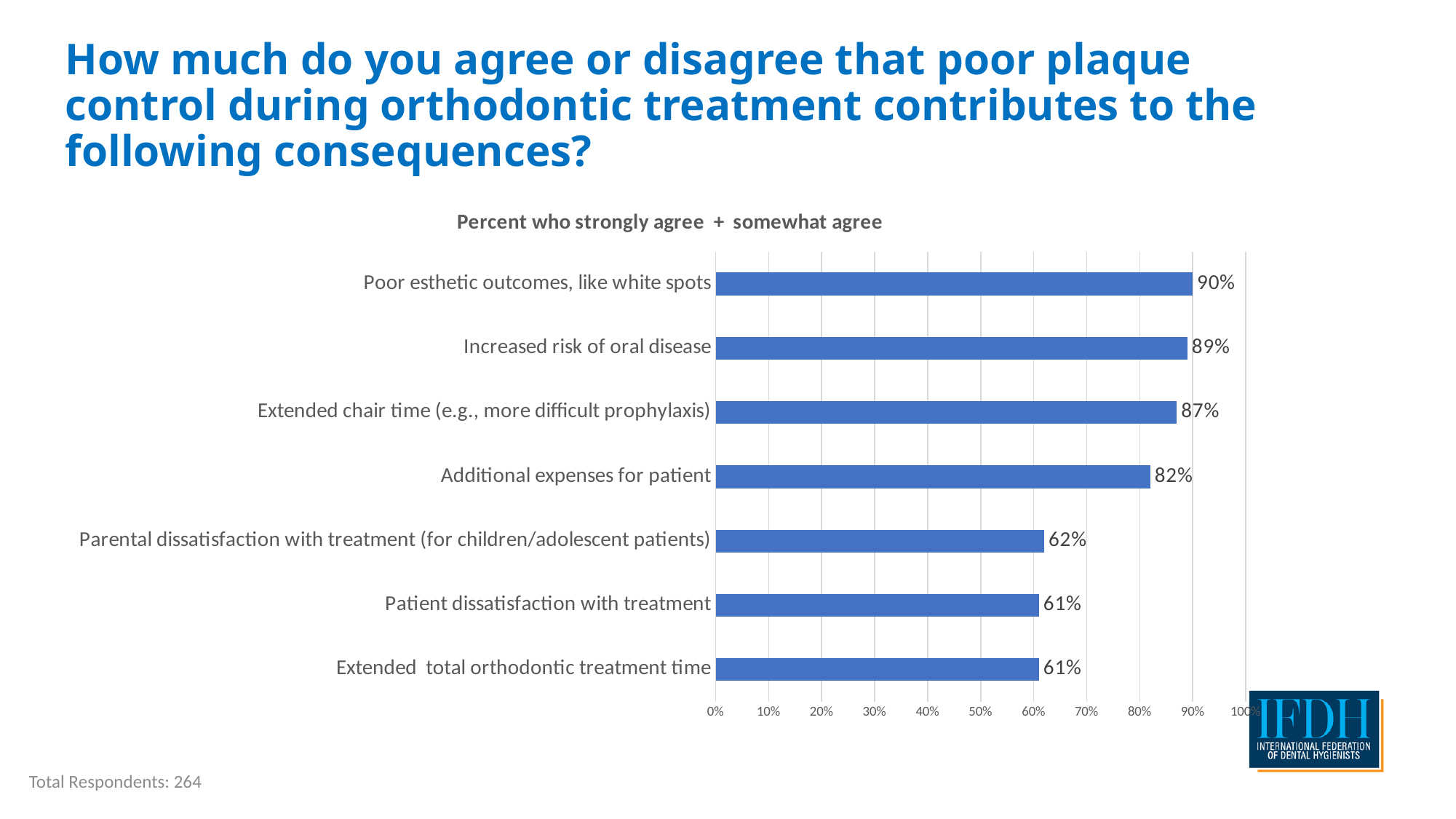
What percent strongly or somewhat agree that poor plaque control contributes to poor esthetic outcomes, like white spots? 90% What is the value for 'Additional expenses for patient'? 82% What is the difference between the values for 'Increased risk of oral disease' and 'Patient dissatisfaction with treatment'? 28% What is the lowest value shown on the chart? 61% How many consequences (categories) are shown on the chart? 7 What kind of chart is shown on the slide? Bar chart How many total respondents are noted on the slide? 264 What is the subtitle of the chart? Percent who strongly agree + somewhat agree Which is larger: the value for 'Extended chair time (e.g., more difficult prophylaxis)' or the value for 'Additional expenses for patient'? Extended chair time (e.g., more difficult prophylaxis) What is the value for 'Parental dissatisfaction with treatment (for children/adolescent patients)'? 62% Is the value for 'Extended total orthodontic treatment time' greater or less than 70%? less Which consequence has the highest percentage of agreement? Poor esthetic outcomes, like white spots